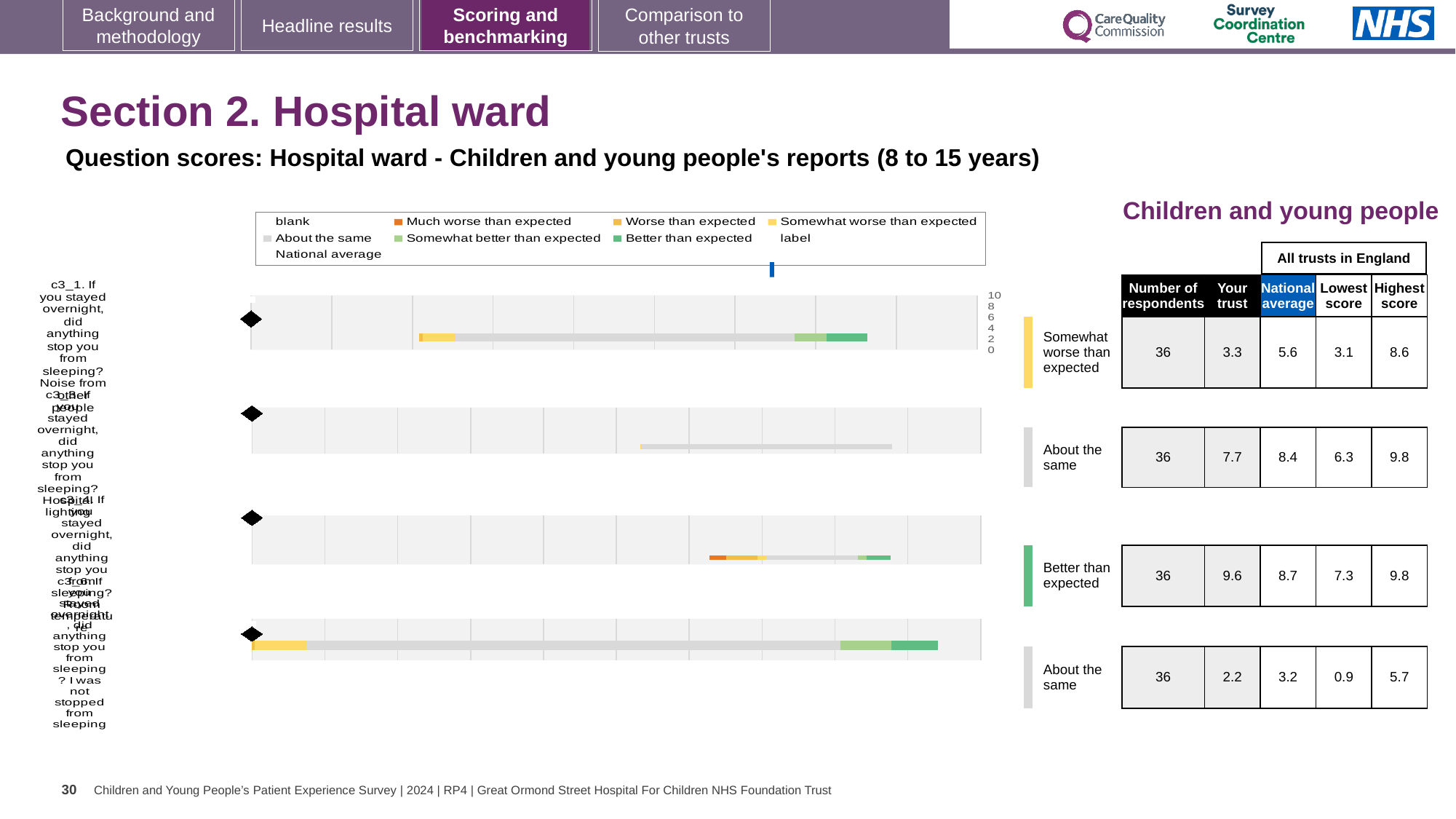
What is the national average for the third row (Better than expected)? 8.7 For the second row (About the same), which is larger: the 'Your trust' score or the national average? the national average (8.4) What is the highest score among all trusts in England for the second row (About the same)? 9.8 Which row has the highest 'Your trust' score? the third row (Better than expected), 9.6 How many respondents are shown for each row? 36 Which row has the lowest 'Your trust' score? the fourth row (About the same), 2.2 For the third row (Better than expected), what is the difference between the 'Your trust' score and the national average? 0.9 What is the 'Your trust' score for the first row (Somewhat worse than expected)? 3.3 For the first row, what is the difference between the national average and the 'Your trust' score? 2.3 How many question rows (bars) are plotted in the chart? 4 What kind of chart is shown on the slide? bar chart What is the lowest score among all trusts in England for the fourth row (About the same)? 0.9